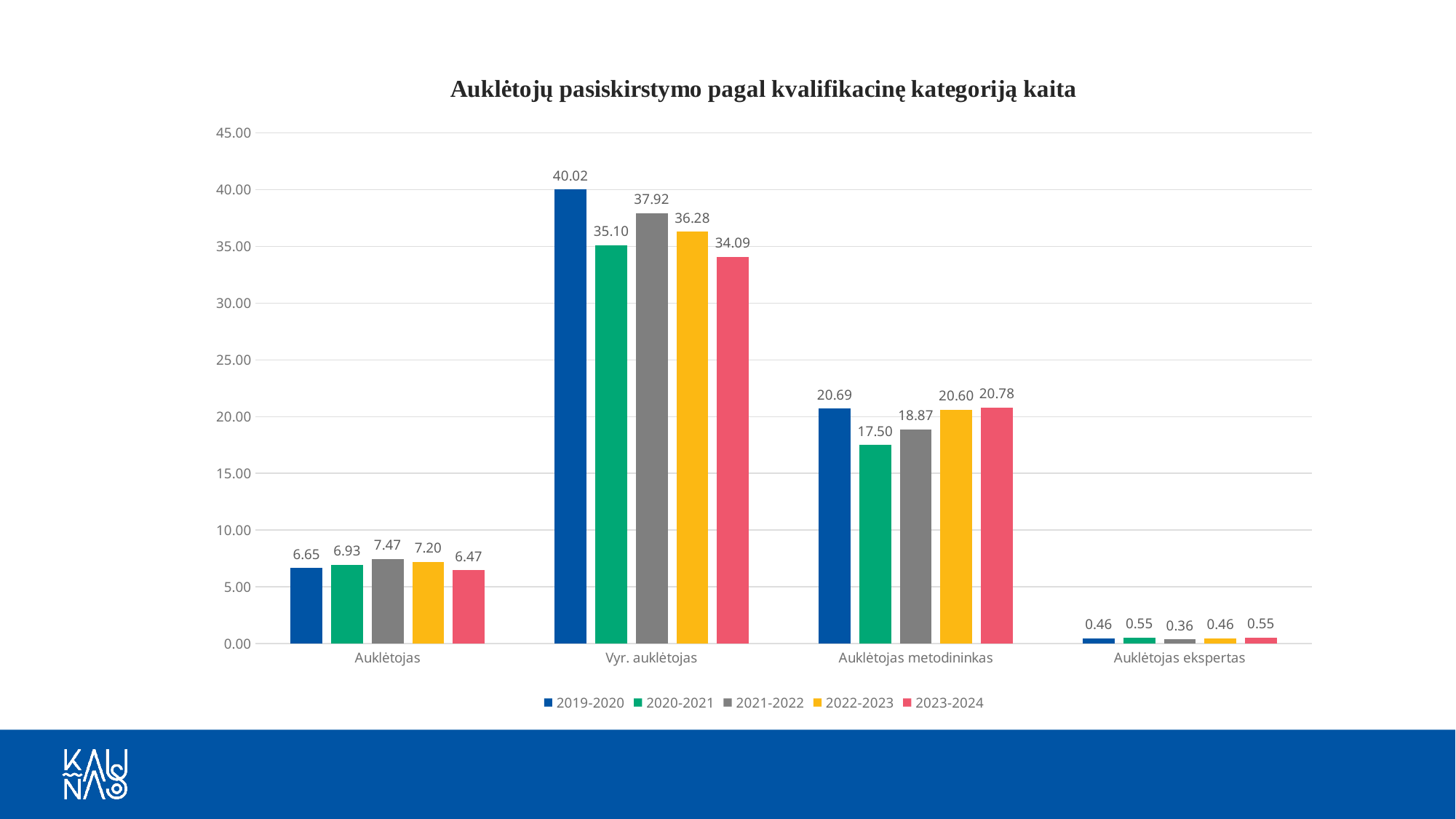
Which category has the lowest value in the 2019-2020 series? Auklėtojas ekspertas Which series is shown in yellow in the legend? 2022-2023 What is the value for Auklėtojas ekspertas in the 2023-2024 series? 0.55 How many series does the legend list? 5 Which category has the highest value in the 2022-2023 series? Vyr. auklėtojas How many categories are shown on the x axis? 4 What kind of chart is shown on the slide? Bar chart What is the value for Vyr. auklėtojas in the 2019-2020 series? 40.02 What is the value for Auklėtojas metodininkas in the 2021-2022 series? 18.87 What is the title of the chart? Auklėtojų pasiskirstymo pagal kvalifikacinę kategoriją kaita Which is larger for Auklėtojas: the 2021-2022 value or the 2023-2024 value? 2021-2022 What is the difference between the 2019-2020 and 2023-2024 values for Vyr. auklėtojas? 5.93